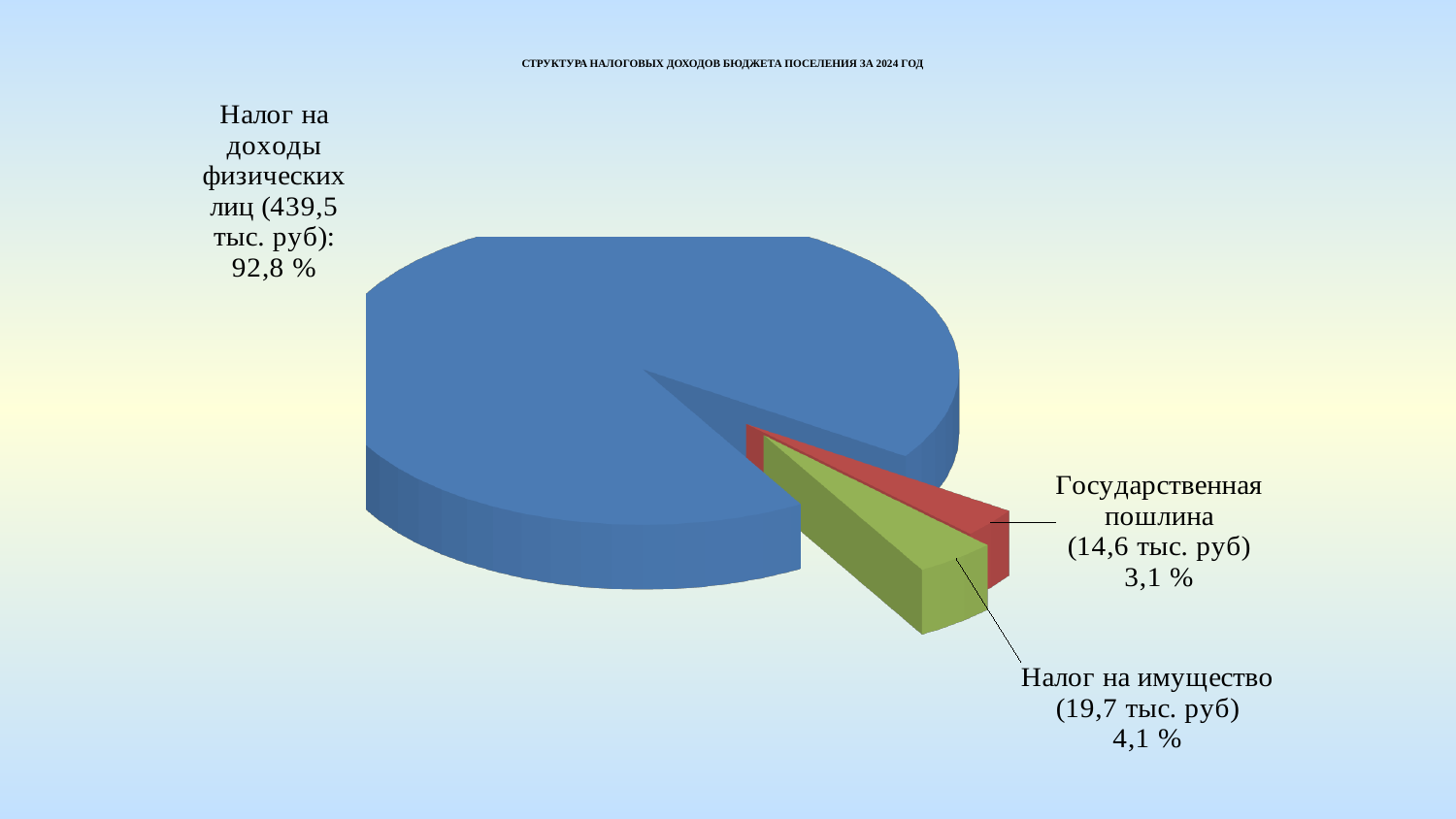
What amount in тыс. руб is shown for "Государственная пошлина"? 14,6 тыс. руб What amount in тыс. руб is shown for "Налог на имущество"? 19,7 тыс. руб Which category has the largest slice of the pie? Налог на доходы физических лиц Which category has the smallest slice of the pie? Государственная пошлина What share of the pie does "Государственная пошлина" represent? 3,1 % What is the difference in percentage points between the shares of "Налог на имущество" and "Государственная пошлина"? 1,0 % Which is larger: the share for "Налог на имущество" or the share for "Государственная пошлина"? Налог на имущество What share of the pie does "Налог на имущество" represent? 4,1 % What amount in тыс. руб is shown for "Налог на доходы физических лиц"? 439,5 тыс. руб What type of chart is shown on the slide? Pie chart What share of the pie does "Налог на доходы физических лиц" represent? 92,8 % How many slices does the pie chart have? 3